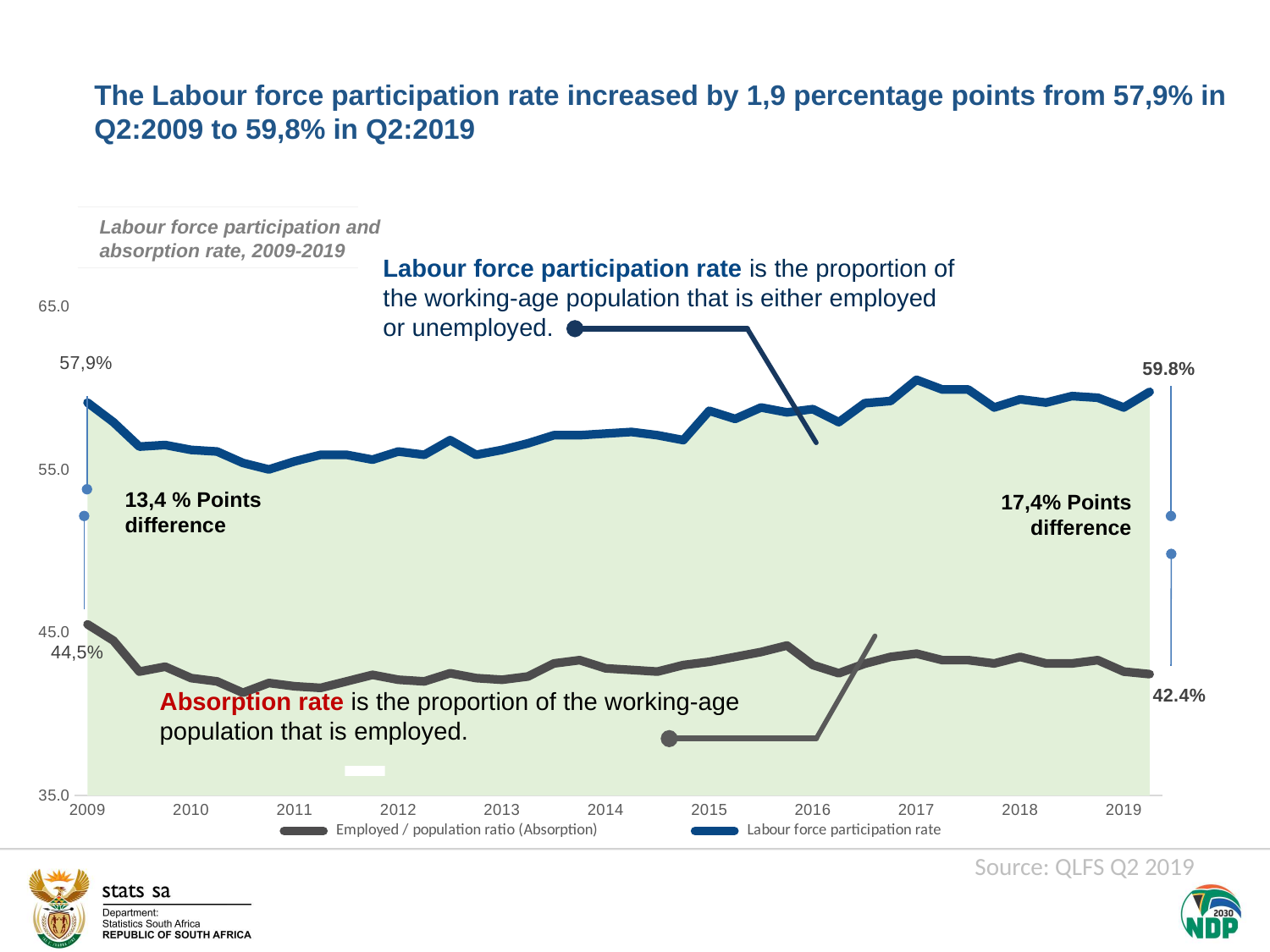
What was the labour force participation rate in 2009 according to the chart? 57,9% What kind of chart is shown on the slide? Area and line chart What was the labour force participation rate in 2019 according to the chart? 59.8% What is the points difference between the two series shown for 2019 on the chart? 17,4% points Which series has the higher value in 2019, the labour force participation rate or the absorption rate? Labour force participation rate What was the employed / population ratio (absorption) in 2019 according to the chart? 42.4% What was the employed / population ratio (absorption) in 2009 according to the chart? 44,5% By how many percentage points did the labour force participation rate change between 2009 and 2019? 1,9 percentage points What is the title of the chart? Labour force participation and absorption rate, 2009-2019 How many series does the chart legend list? 2 Is the labour force participation rate in 2017 greater or less than 55.0? greater Does the employed / population ratio (absorption) rise or fall overall from 2009 to 2019? Fall